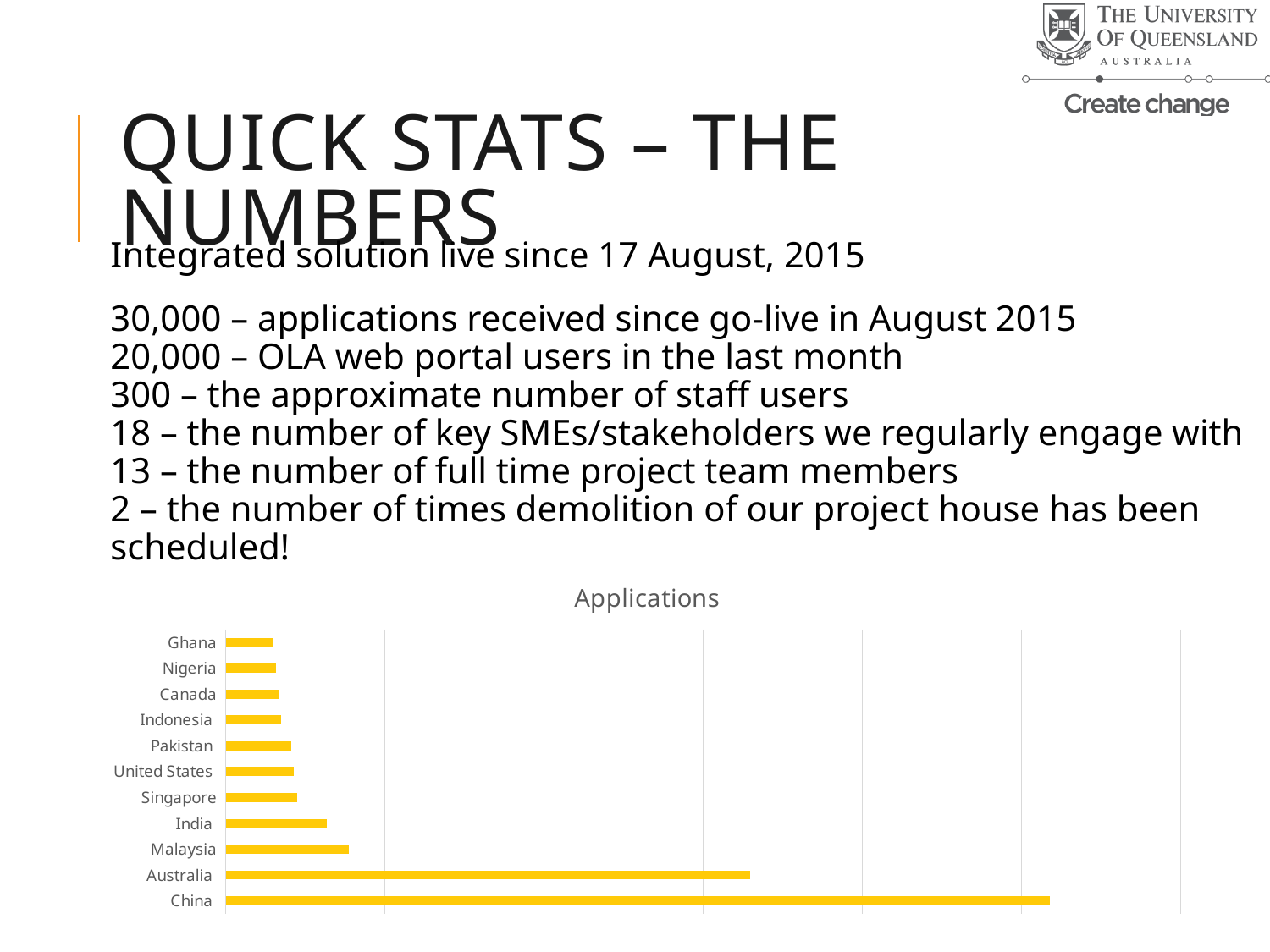
Which has more applications, Australia or Malaysia? Australia Which has more applications, India or Singapore? India What colour are the bars in the Applications chart? yellow Which country has the highest number of applications in the chart? China Which has more applications, Malaysia or India? Malaysia Which country has the second-longest bar in the Applications chart? Australia How many countries are shown in the Applications chart? 11 Which country is listed at the top of the Applications chart? Ghana What kind of chart is shown on the slide? bar chart What is the title of the chart? Applications